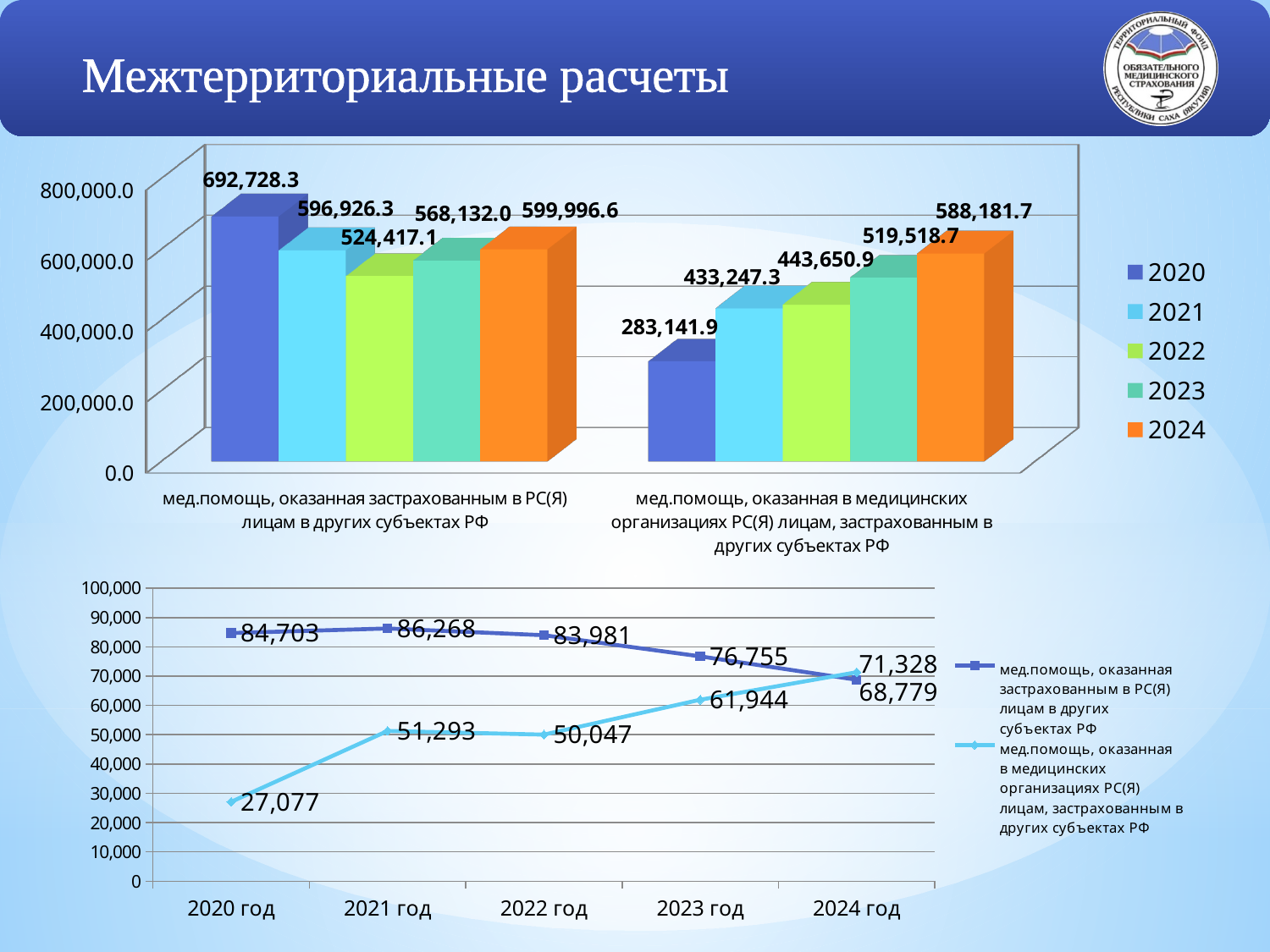
In the bottom line chart, what is the difference between the two series in 2024? 2,549 In the bottom line chart, what is the 2021 value for medical care provided to persons insured in RS(Ya) in other subjects of the RF (dark blue line)? 86,268 How many series does the legend of the top bar chart list? 5 In the bottom line chart, what is the 2023 value for medical care provided in medical organizations of RS(Ya) to persons insured in other subjects of the RF (light blue line)? 61,944 How many years are shown on the x axis of the bottom line chart? 5 In the bottom line chart, does the light blue line (care provided in RS(Ya) organizations to persons insured elsewhere) generally rise or fall from 2020 to 2024? Rise In the top bar chart, what is the 2024 value for medical care provided in medical organizations of RS(Ya) to persons insured in other subjects of the RF (right group)? 588,181.7 In the top bar chart, which year has the highest value in the left group (care provided to RS(Ya) insured persons in other subjects)? 2020 In the top bar chart, which year has the lowest value in the right group (care provided in RS(Ya) organizations to persons insured elsewhere)? 2020 What kind of chart is the top chart on the slide? Bar chart In the top bar chart, what is the difference between the 2021 and 2022 values in the left group? 72,509.2 In the top bar chart, what is the 2020 value for medical care provided to persons insured in RS(Ya) in other subjects of the RF (left group)? 692,728.3